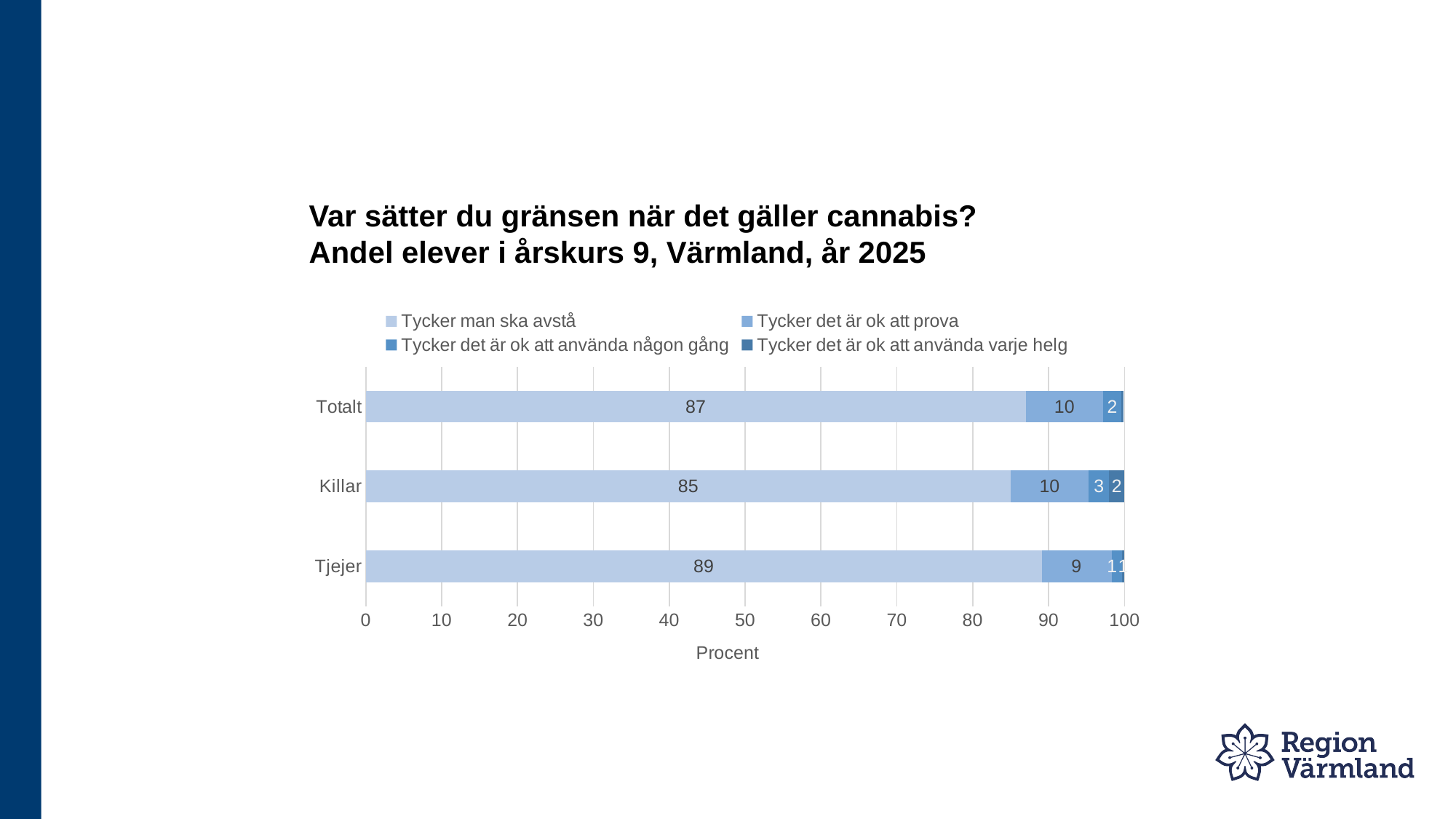
What is the value for Tjejer in the series "Tycker det är ok att prova"? 9 What kind of chart is shown on the slide? Stacked bar chart Which is larger for "Tycker det är ok att prova": Killar or Tjejer? Killar How many categories are shown on the y axis? 3 What is the value for Killar in the series "Tycker man ska avstå"? 85 How many series does the legend list? 4 Which category has the highest value for "Tycker man ska avstå"? Tjejer What is the difference between Tjejer and Killar in the series "Tycker man ska avstå"? 4 What is the value for Killar in the series "Tycker det är ok att använda varje helg"? 2 What is the value for Killar in the series "Tycker det är ok att använda någon gång"? 3 Which category has the lowest value for "Tycker man ska avstå"? Killar What is the value for Totalt in the series "Tycker man ska avstå"? 87